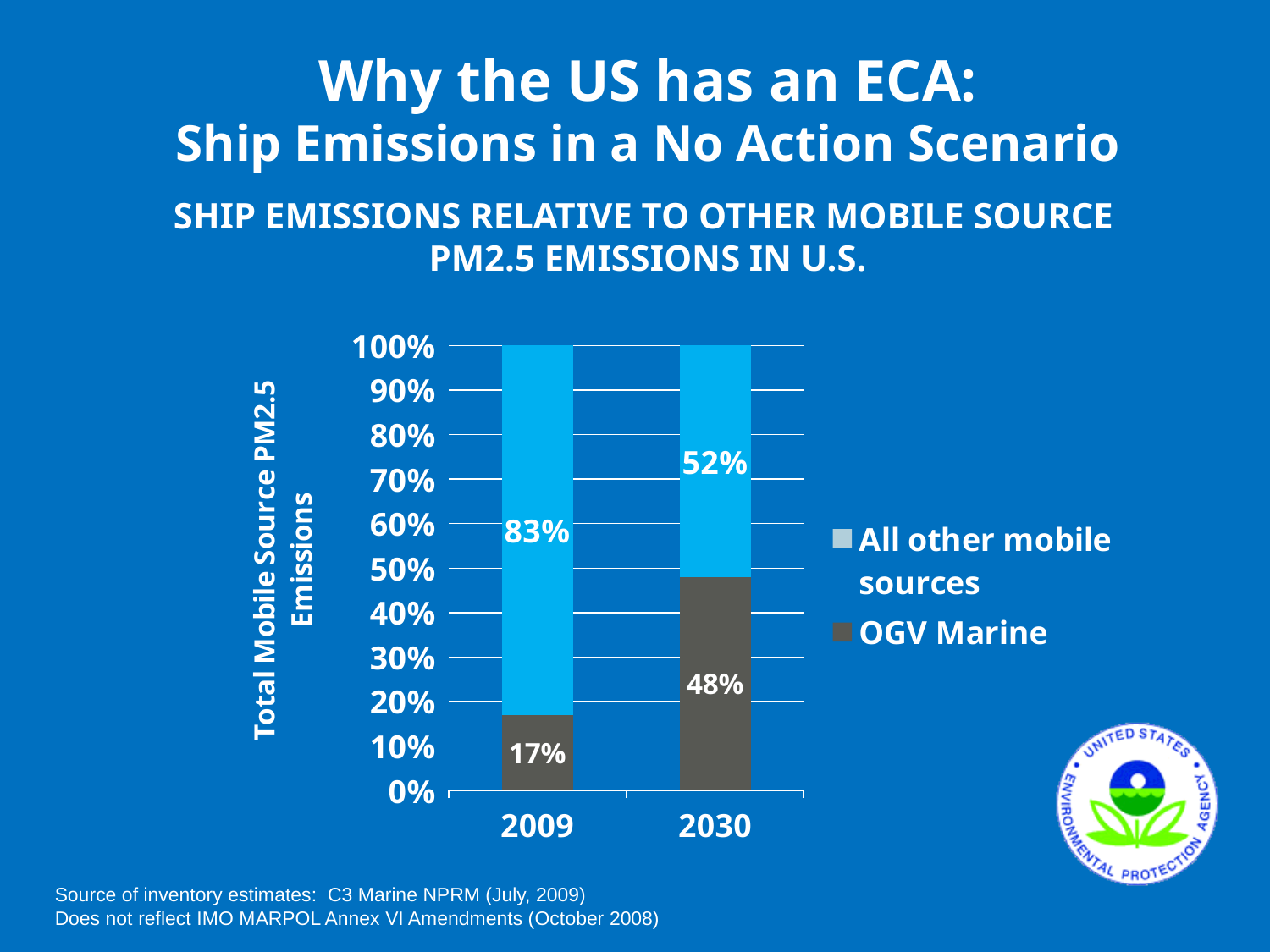
Is the OGV Marine value for 2030 greater or less than 40%? greater By how many percentage points does the OGV Marine share increase from 2009 to 2030? 31% What is the value for All other mobile sources in 2009? 83% How many series does the legend list? 2 In which year is the All other mobile sources share lower? 2030 In which year is the OGV Marine share higher? 2030 What kind of chart is shown on the slide? Stacked bar chart How many years are shown on the x axis? 2 Which is larger in 2030: the OGV Marine share or the All other mobile sources share? All other mobile sources What is the OGV Marine share of total mobile source PM2.5 emissions in 2030? 48% What is the value for All other mobile sources in 2030? 52% What is the OGV Marine share of total mobile source PM2.5 emissions in 2009? 17%